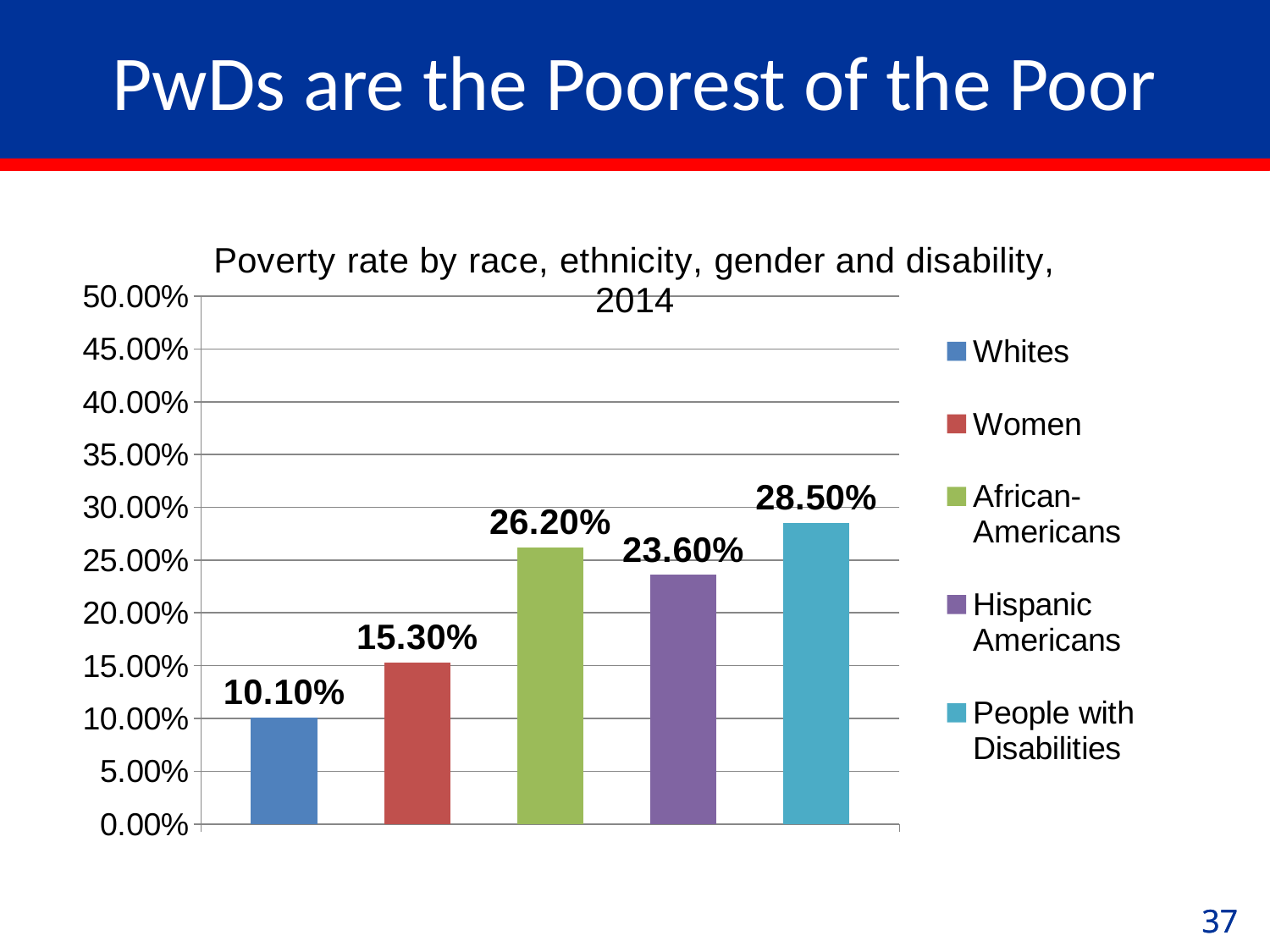
Which group has the highest poverty rate? People with Disabilities What is the poverty rate for People with Disabilities? 28.50% What is the title of the chart? Poverty rate by race, ethnicity, gender and disability, 2014 How many groups are shown in the chart? 5 What kind of chart is shown on the slide? bar chart Is the poverty rate for Women greater or less than 20.00%? less What is the poverty rate for Whites? 10.10% What is the poverty rate for Hispanic Americans? 23.60% Which has a higher poverty rate, Women or African-Americans? African-Americans What is the difference between the poverty rate for African-Americans and for Hispanic Americans? 2.60% Which group has the lowest poverty rate? Whites What is the difference between the poverty rate for People with Disabilities and for Whites? 18.40%